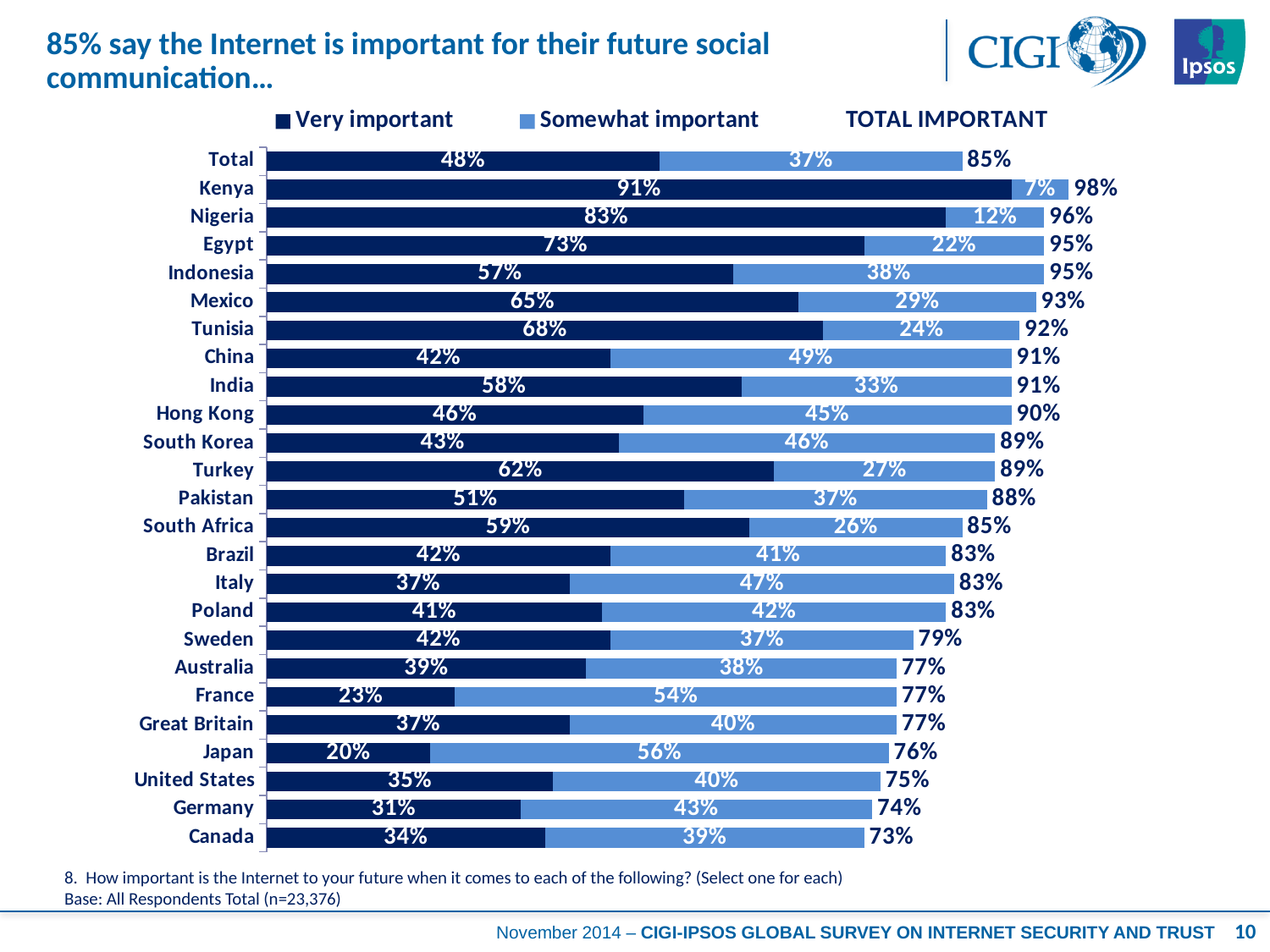
Which has a larger 'Somewhat important' value, China or India? China What percentage of respondents in Kenya say the Internet is very important for their future social communication? 91% Which country has the highest 'Very important' percentage? Kenya What is the base size (n) stated below the chart? n=23,376 What kind of chart is shown on the slide? Stacked bar chart What is the TOTAL IMPORTANT value for Canada? 73% How many rows (countries plus Total) are plotted in the chart? 25 What is the difference between the 'Very important' values for Egypt and France? 50% What is the total of the stacked bar for Germany? 74% What is the 'Somewhat important' value for Japan? 56% How many series does the legend list? 3 Which country has the lowest TOTAL IMPORTANT percentage? Canada